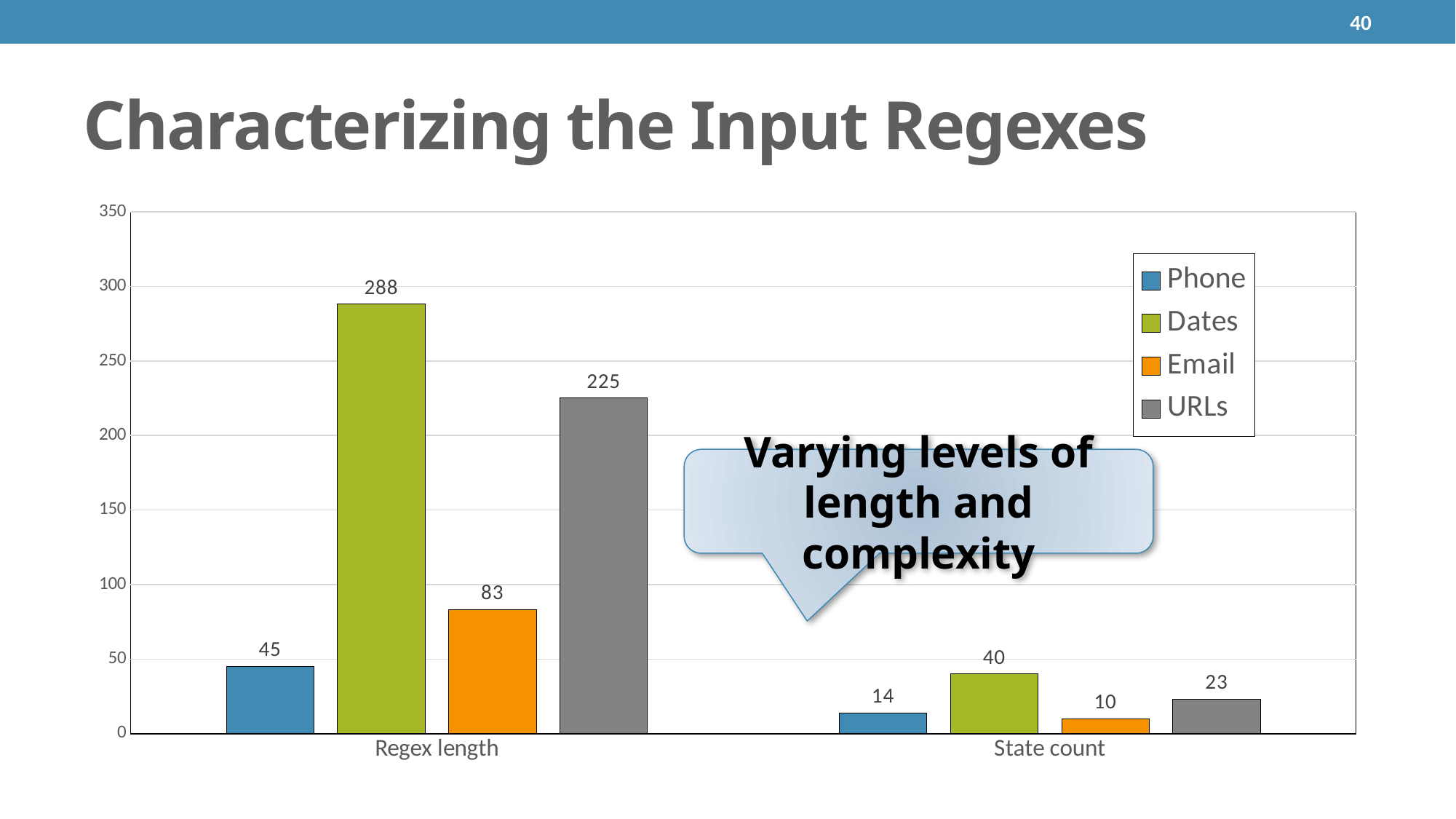
Which series has the lowest State count? Email What is the State count value for Email? 10 What is the Regex length value for URLs? 225 What is the difference between the Regex length for Dates and for URLs? 63 Which is larger, the State count for Phone or for URLs? URLs How many series does the legend list? 4 What kind of chart is shown on the slide? bar chart Is the Regex length value for Email greater or less than 100? less How many categories are shown on the x axis? 2 What is the Regex length value for Dates? 288 What colour are the bars for the Email series? orange Which series has the highest Regex length? Dates